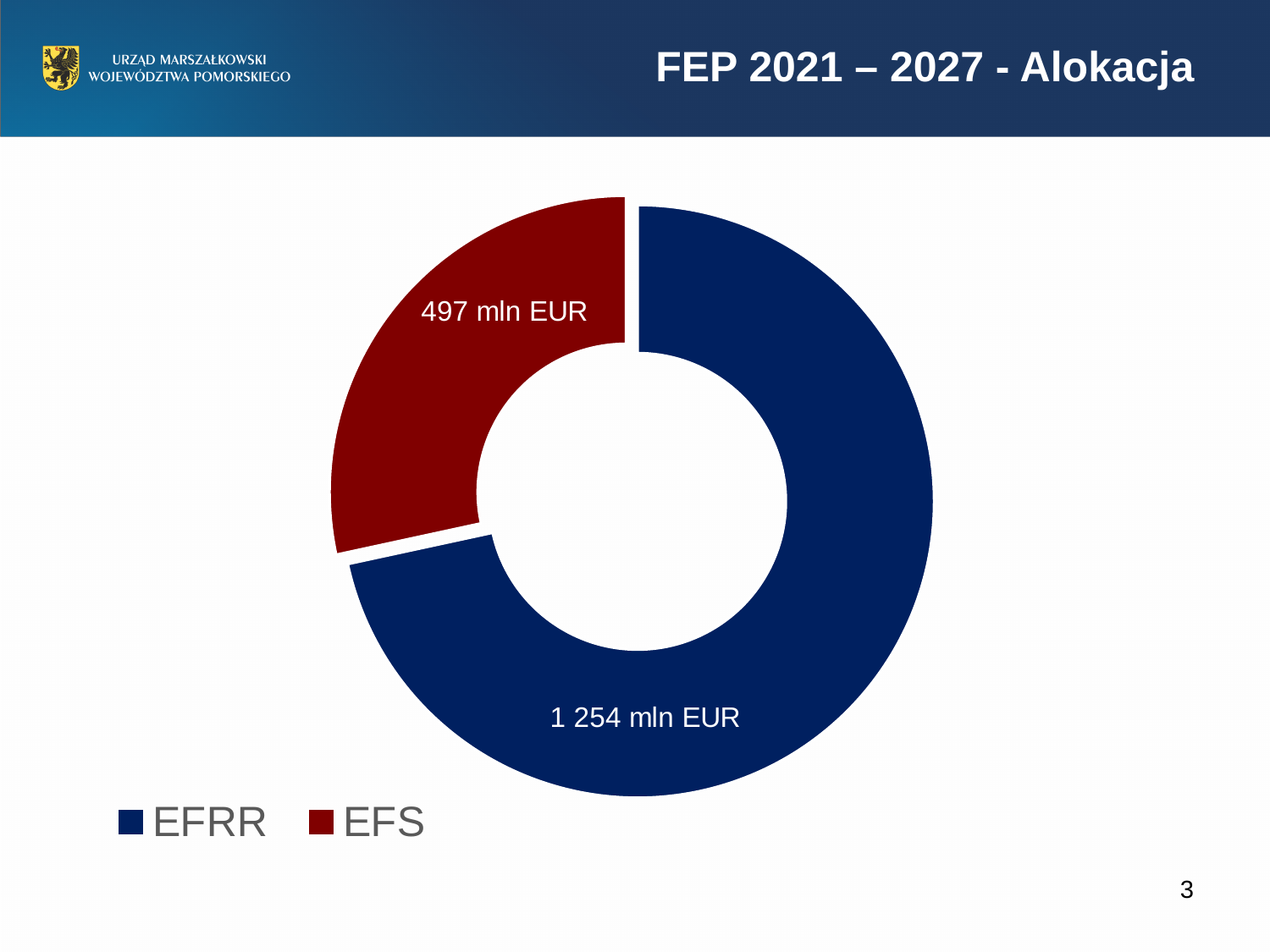
Which category has the largest share of the chart? EFRR What is the title of the slide containing the chart? FEP 2021 – 2027 - Alokacja What is the total of the EFRR and EFS values? 1 751 mln EUR Which is larger, EFRR or EFS? EFRR What is the value for EFRR? 1 254 mln EUR Which category has the smallest share of the chart? EFS What kind of chart is shown on the slide? Doughnut chart What is the value for EFS? 497 mln EUR What colour is the EFS slice? Red How many entries does the legend list? 2 What is the difference between the EFRR and EFS values? 757 mln EUR How many categories does the chart show? 2